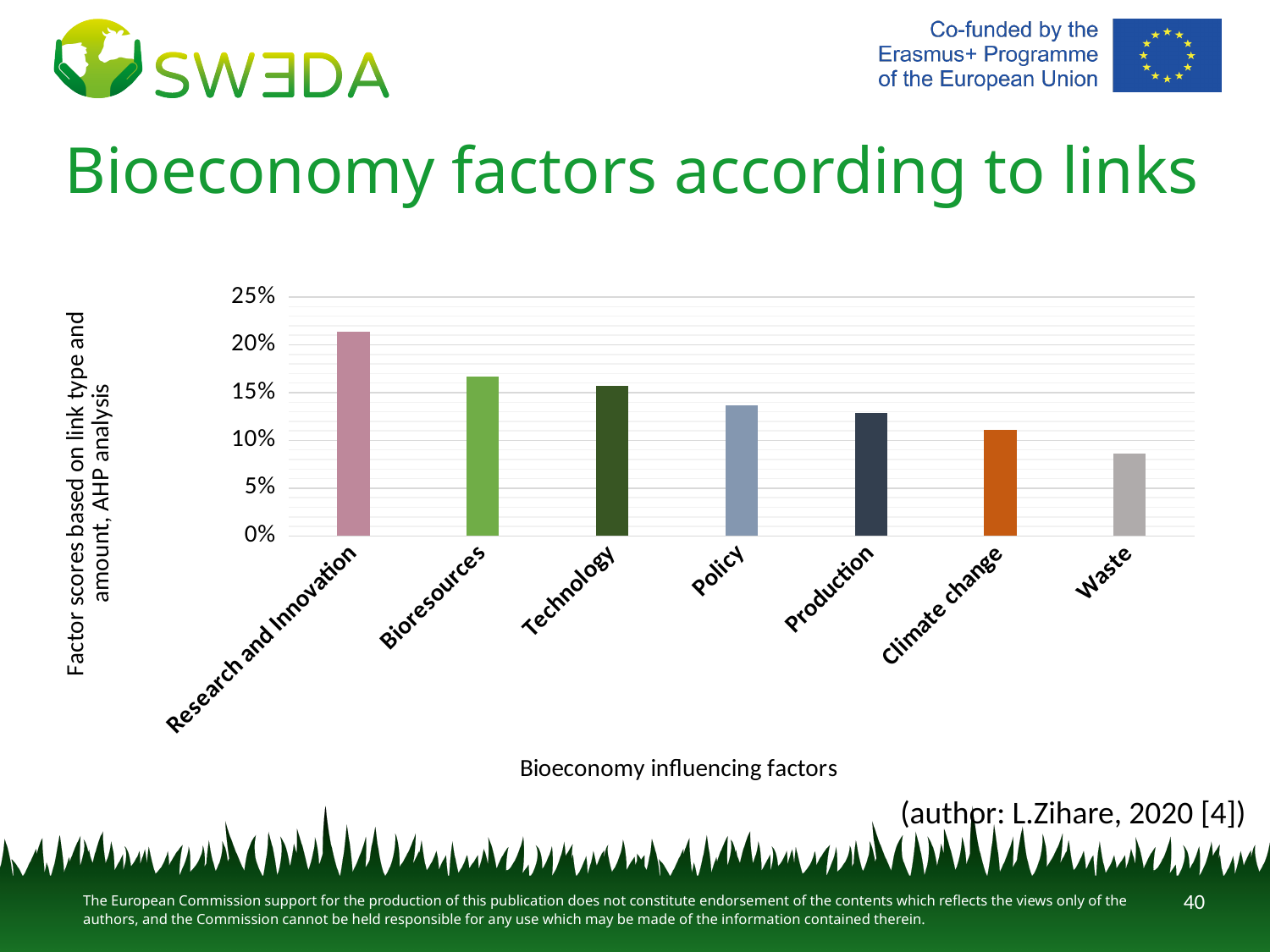
Which bioeconomy influencing factor has the lowest factor score? Waste Is the factor score for Waste greater or less than 10%? less Is the factor score for Bioresources greater or less than 15%? greater Do the factor scores rise or fall from left to right across the categories? fall Which bioeconomy influencing factor has the highest factor score? Research and Innovation What kind of chart is shown on the slide? bar chart Is the factor score for Research and Innovation greater or less than 20%? greater Which has a higher factor score, Technology or Climate change? Technology Which has a higher factor score, Production or Waste? Production How many bioeconomy influencing factors are shown in the chart? 7 What is the label of the vertical axis of the chart? Factor scores based on link type and amount, AHP analysis